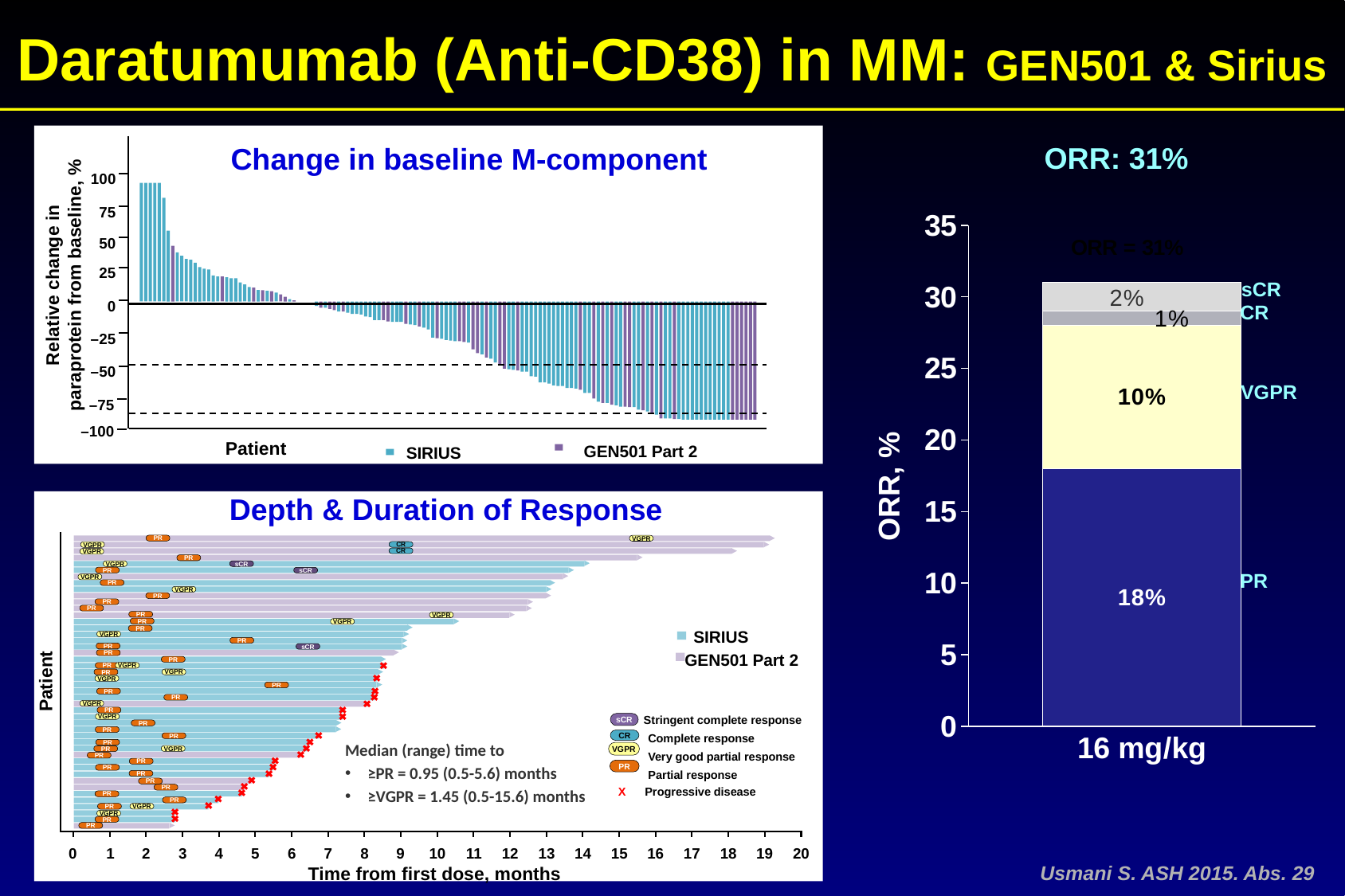
In the ORR: 31% stacked bar chart, which response category has the largest segment? PR What kind of chart is the Change in baseline M-component chart? Bar chart In the Change in baseline M-component chart, how many series does the legend list? 2 In the ORR: 31% stacked bar chart, what is the value of the PR segment? 18% In the ORR: 31% stacked bar chart, which segment is larger, sCR or CR? sCR In the ORR: 31% stacked bar chart, which response category has the smallest segment? CR In the Depth & Duration of Response chart, what is the median time to ≥VGPR? 1.45 months In the ORR: 31% stacked bar chart, what is the difference between the PR and VGPR segments? 8% In the ORR: 31% stacked bar chart, what dose is labelled on the x axis? 16 mg/kg In the ORR: 31% stacked bar chart, what is the value of the VGPR segment? 10% In the ORR: 31% stacked bar chart, what is the value of the sCR segment? 2% In the ORR: 31% stacked bar chart, what is the total of the stacked bar for 16 mg/kg? 31%